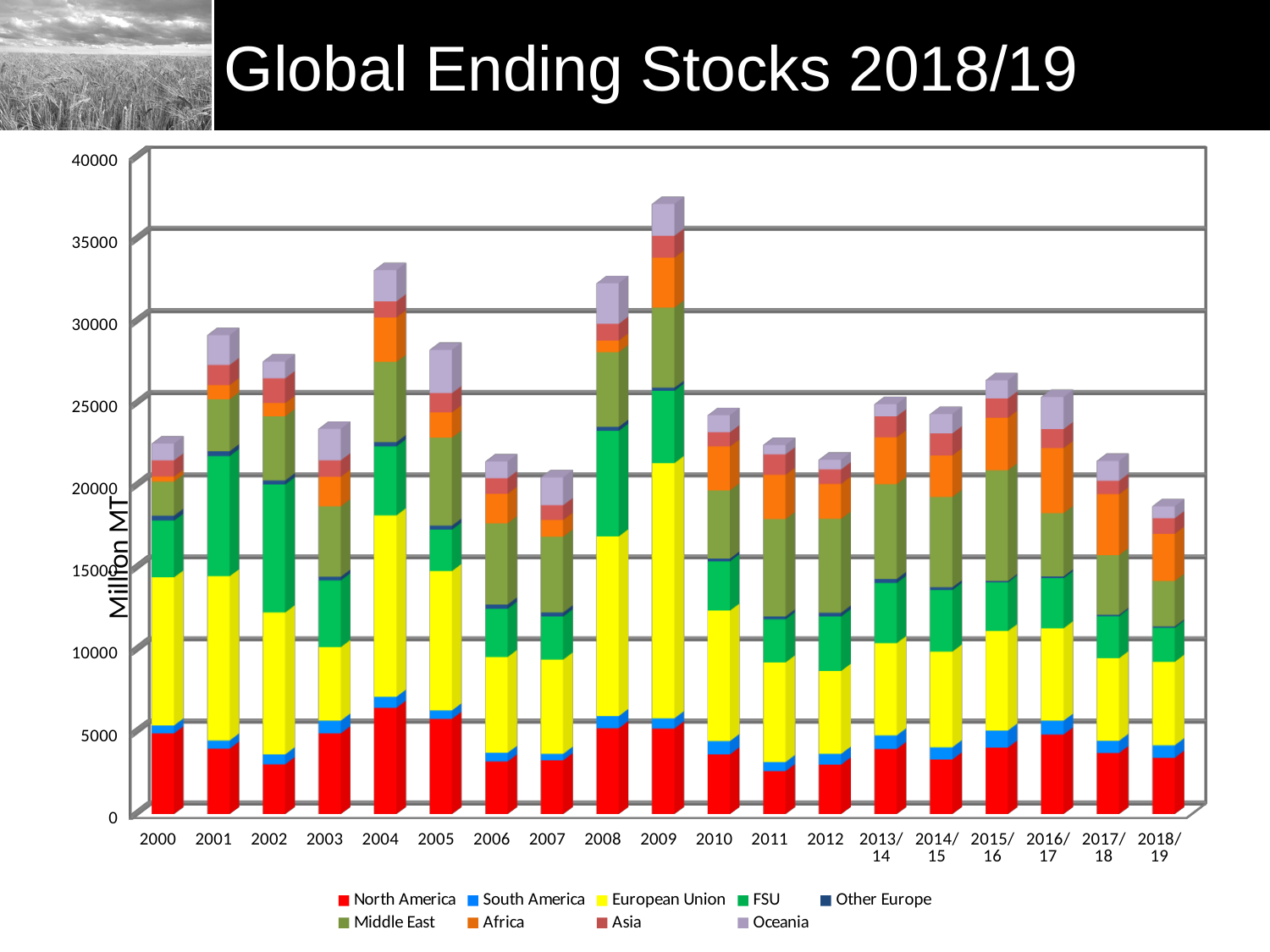
Which year has the lowest total ending stocks? 2018/19 Which year has the highest total ending stocks? 2009 Which year has a larger total, 2008 or 2009? 2009 How many years (categories) are shown along the x axis? 19 What is the label on the vertical axis? Million MT What kind of chart is shown on the slide? stacked bar chart What is the title of the slide? Global Ending Stocks 2018/19 Is the total stacked value for 2004 greater or less than 30000? greater How many series does the legend list? 9 Is the total stacked value for 2009 greater or less than 35000? greater Which year has a larger total, 2004 or 2005? 2004 Is the total stacked value for 2018/19 greater or less than 20000? less